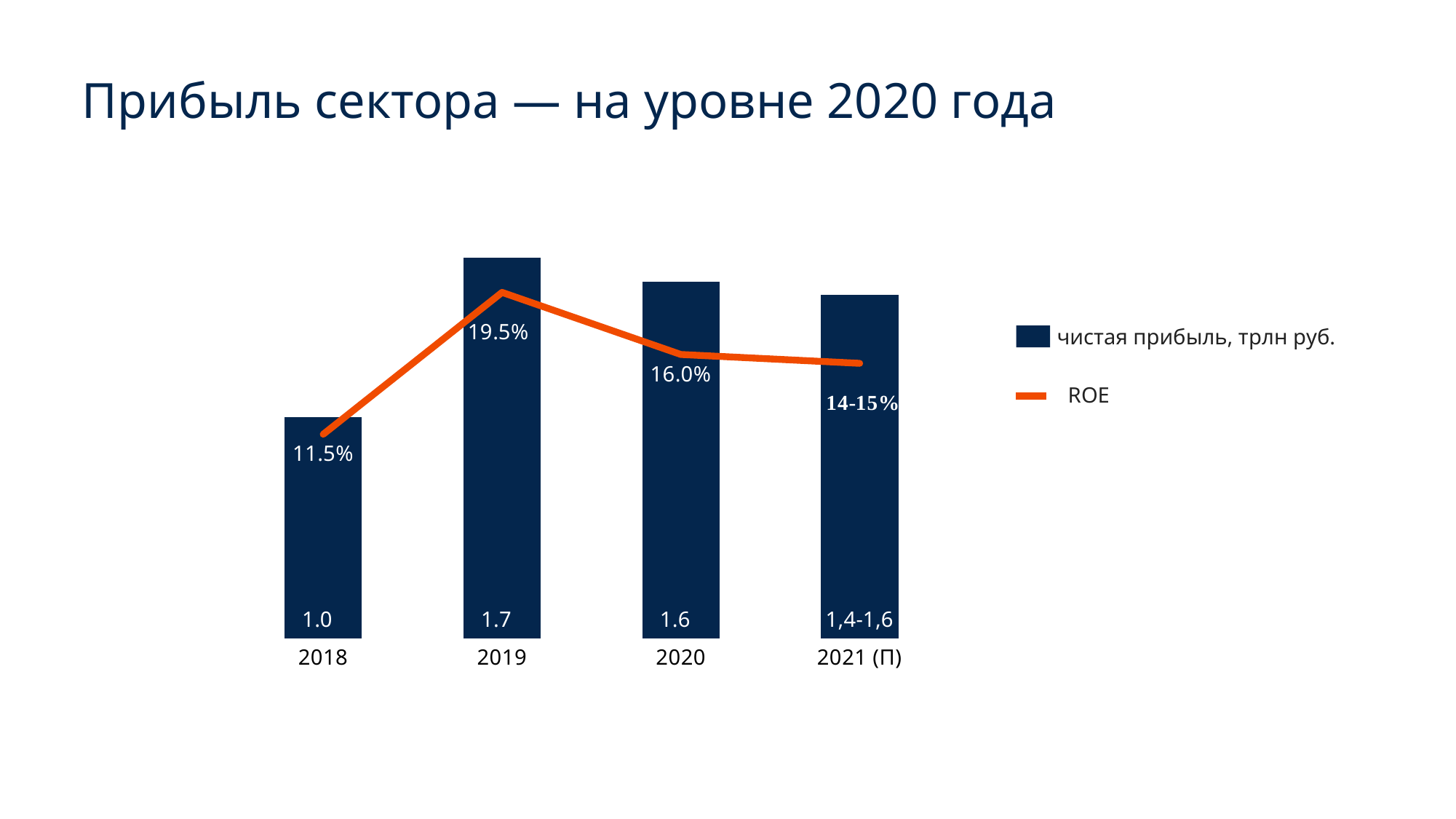
What is the difference in net profit between 2019 and 2018? 0.7 Which year has the lowest ROE? 2018 How many years are shown on the x axis? 4 What is the ROE value shown for 2021 (П)? 14-15% How many series does the legend list? 2 What is the net profit (чистая прибыль) value for 2019? 1.7 What is the title of the slide? Прибыль сектора — на уровне 2020 года What is the difference in ROE between 2019 and 2020? 3.5% Which year has the highest net profit? 2019 What is the ROE value for 2020? 16.0% Which is larger, the net profit for 2020 or for 2018? 2020 What is the net profit value shown for 2021 (П)? 1,4-1,6